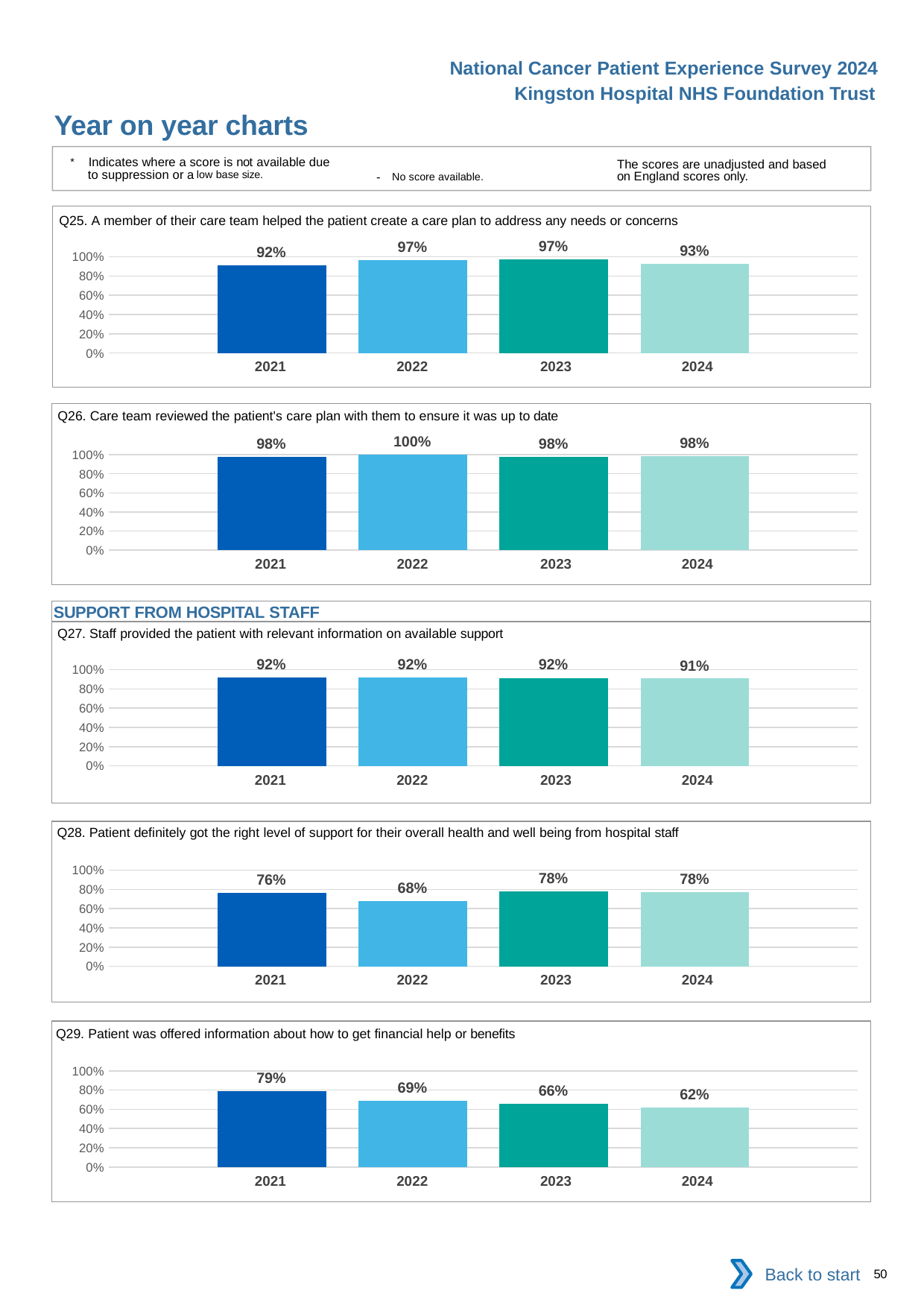
In the Q26 chart, what is the value for 2024? 98% In the Q25 chart, which is larger, the value for 2021 or the value for 2022? 2022 In the Q26 chart, which year has the highest value? 2022 In the Q28 chart, which year has the lowest value? 2022 In the Q29 chart, what is the difference between the 2021 value and the 2024 value? 17% In the Q27 chart, what is the value for 2024? 91% What kind of chart is the Q28 chart? bar chart In the Q29 chart, do the values rise or fall from 2021 to 2024? fall In the Q28 chart, what is the difference between the 2023 value and the 2022 value? 10% In the Q29 chart, what is the value for 2021? 79% In the Q25 chart, what is the value for 2022? 97% How many years are shown in the Q27 chart? 4